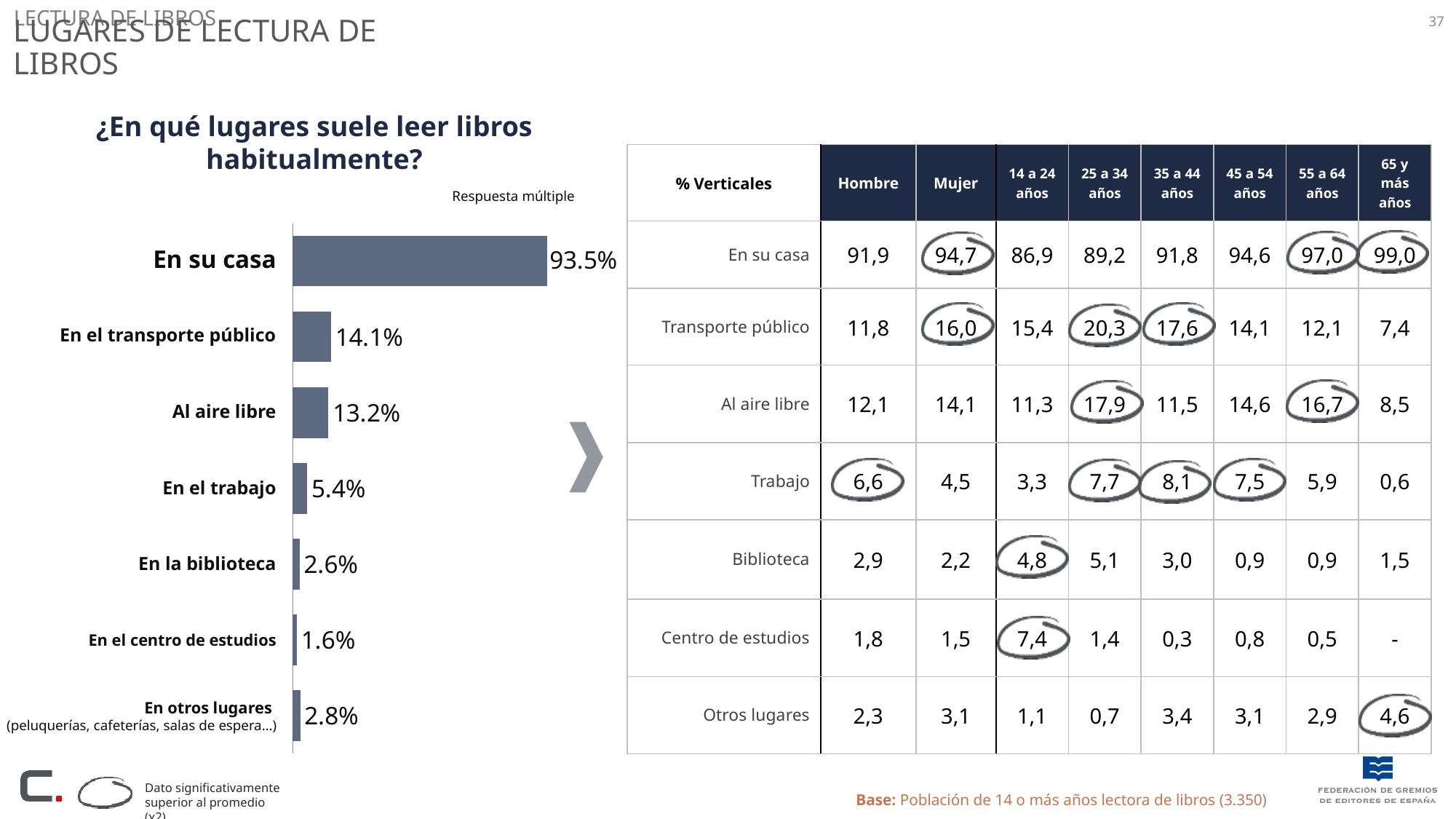
What is the value for 'En el transporte público' in the bar chart? 14.1% What is the title of the bar chart? ¿En qué lugares suele leer libros habitualmente? What is the difference between the values for 'En su casa' and 'En el transporte público' in the bar chart? 79.4 percentage points What kind of chart is shown on the left of the slide? Bar chart Which category has the highest value in the bar chart? En su casa Which is larger in the bar chart: 'En la biblioteca' or 'En otros lugares'? En otros lugares What is the value for 'Al aire libre' in the bar chart? 13.2% How many categories are shown in the bar chart? 7 What is the value for 'En el centro de estudios' in the bar chart? 1.6% What is the value for 'En su casa' in the bar chart? 93.5% What is the value for 'En el trabajo' in the bar chart? 5.4% Which category has the lowest value in the bar chart? En el centro de estudios